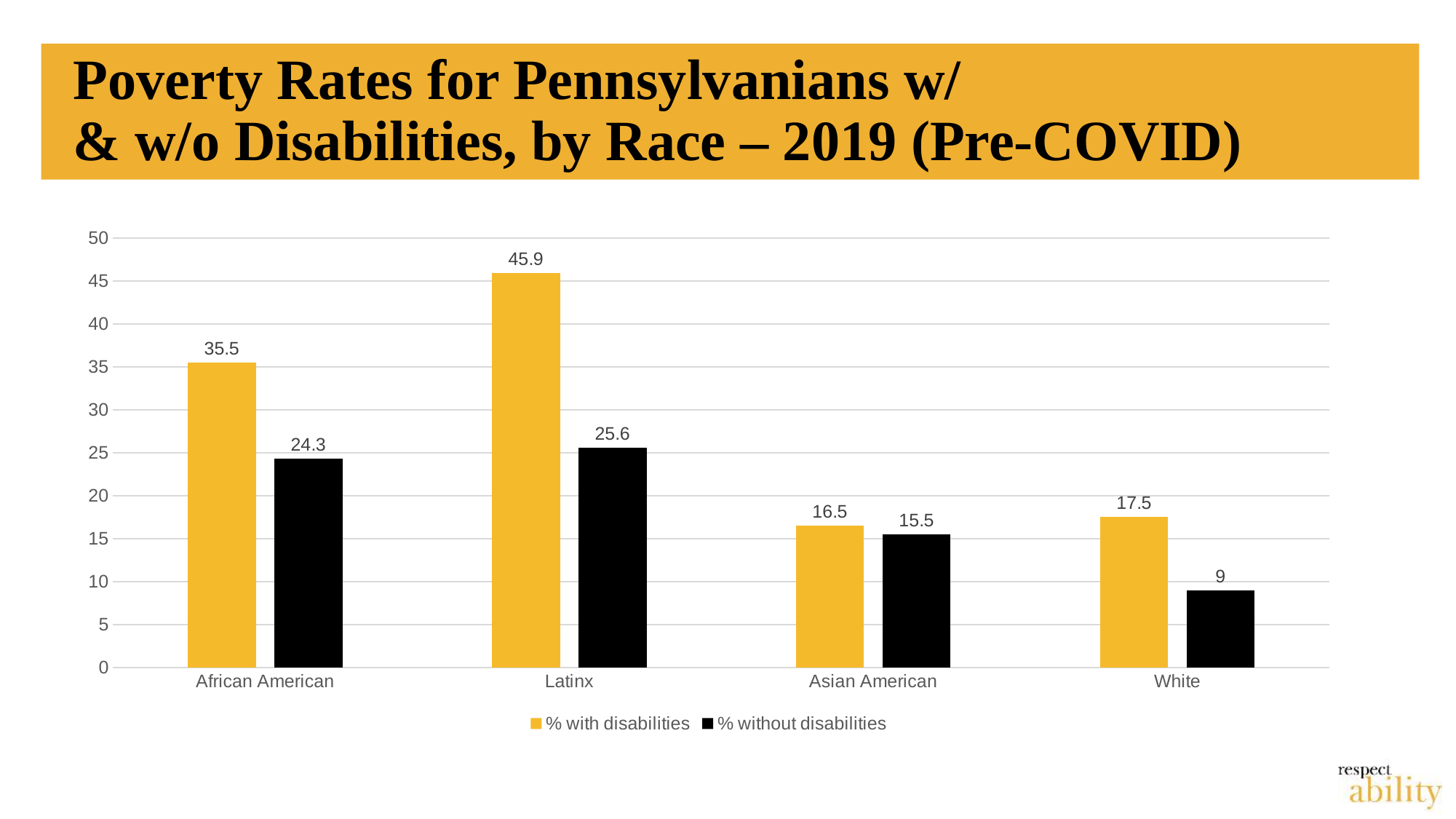
What is the difference between the '% with disabilities' and '% without disabilities' values for African American? 11.2 How many series does the legend list? 2 Which is larger: the '% with disabilities' value for African American or for White? African American What is the poverty rate for Latinx Pennsylvanians with disabilities? 45.9 Which race group has the highest poverty rate among people with disabilities? Latinx Which race group has the lowest poverty rate among people without disabilities? White What is the value for Asian American in the '% without disabilities' series? 15.5 What kind of chart is shown on the slide? Bar chart How many race categories are shown on the x axis? 4 Which colour represents the '% without disabilities' series? Black What is the difference between the Latinx and White values in the '% with disabilities' series? 28.4 What is the poverty rate for White Pennsylvanians without disabilities? 9